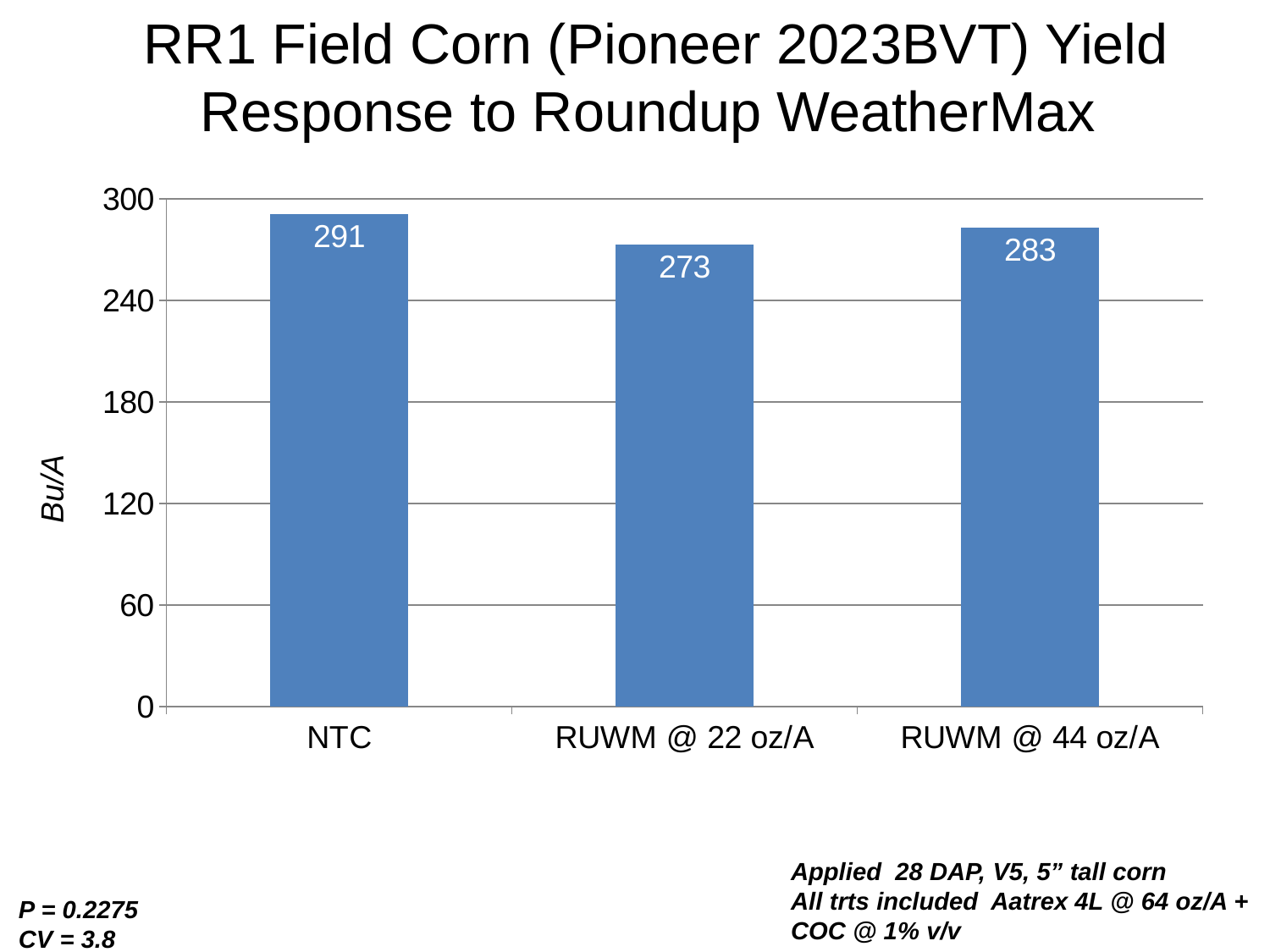
What is the yield for NTC? 291 Which treatment has the lowest yield? RUWM @ 22 oz/A What is the difference in yield between NTC and RUWM @ 22 oz/A? 18 How many treatments are shown in the chart? 3 What is the yield for RUWM @ 44 oz/A? 283 Which treatment has the highest yield? NTC What is the label on the y axis of the chart? Bu/A What kind of chart is shown on the slide? bar chart What is the difference in yield between RUWM @ 44 oz/A and RUWM @ 22 oz/A? 10 Which has a higher yield, NTC or RUWM @ 44 oz/A? NTC Is the yield for RUWM @ 22 oz/A greater or less than 240? greater What is the yield for RUWM @ 22 oz/A? 273